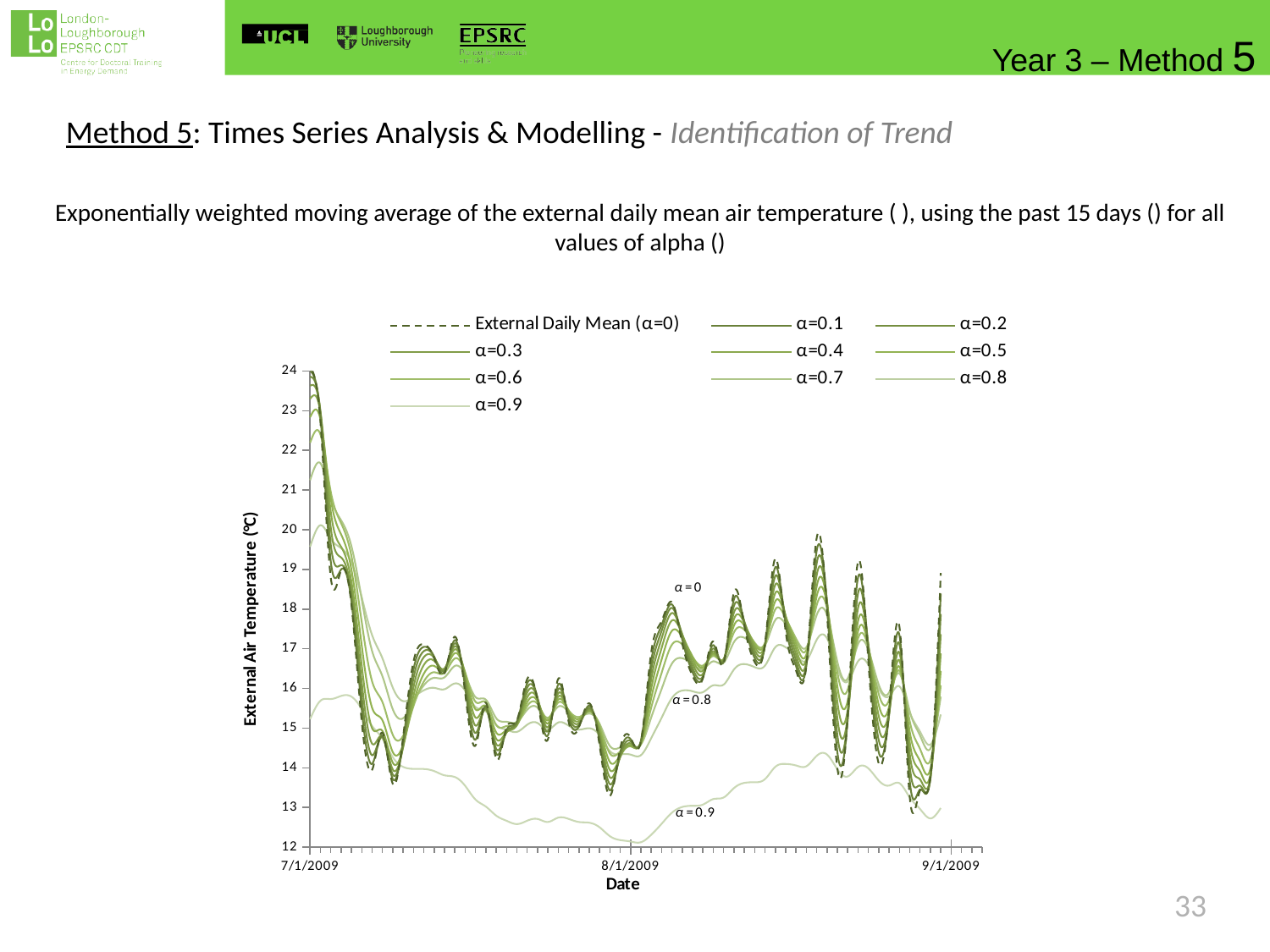
Which series reaches the lowest value on the chart? α=0.9 Does the α=0.9 line rise or fall between 7/1/2009 and 8/1/2009? fall What is the title of the vertical axis of the chart? External Air Temperature (°C) Is the value of the α=0.9 line at 8/1/2009 greater or less than 13? less How many series does the chart legend list? 10 How many date labels are shown on the x axis? 3 What kind of chart is shown on the slide? line chart Near 8/1/2009, is the α=0.8 line higher or lower than the α=0.9 line? higher Is the value of the External Daily Mean (α=0) line at 7/1/2009 greater or less than 22? greater Which series in the legend is drawn with a dashed line? External Daily Mean (α=0) What is the highest value shown on the y axis? 24